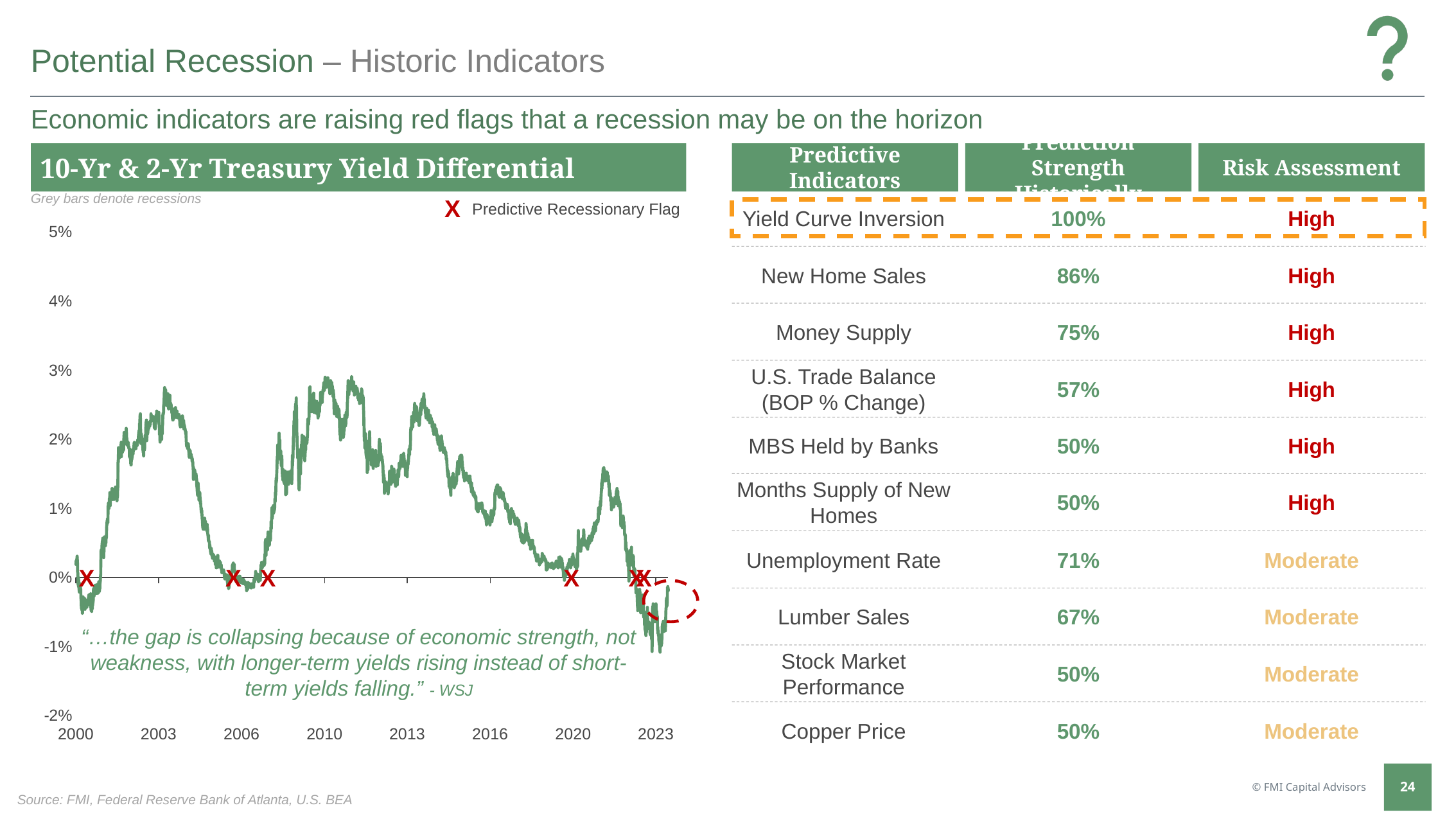
In the 10-Yr & 2-Yr Treasury Yield Differential chart, what do the red X markers denote? Predictive Recessionary Flag In the 10-Yr & 2-Yr Treasury Yield Differential chart, does the line generally rise or fall between 2000 and 2003? rise In the 10-Yr & 2-Yr Treasury Yield Differential chart, is the value in 2023 greater or less than 0%? less What kind of chart is the 10-Yr & 2-Yr Treasury Yield Differential chart? line chart In the 10-Yr & 2-Yr Treasury Yield Differential chart, is the value in 2010 greater or less than 2%? greater In the 10-Yr & 2-Yr Treasury Yield Differential chart, is the value in 2006 greater or less than 1%? less In the 10-Yr & 2-Yr Treasury Yield Differential chart, what is the highest value shown on the y axis? 5% In the 10-Yr & 2-Yr Treasury Yield Differential chart, what is the lowest value shown on the y axis? -2% In the 10-Yr & 2-Yr Treasury Yield Differential chart, how many year labels are shown on the x axis? 8 In the 10-Yr & 2-Yr Treasury Yield Differential chart, does the line generally rise or fall between 2010 and 2020? fall